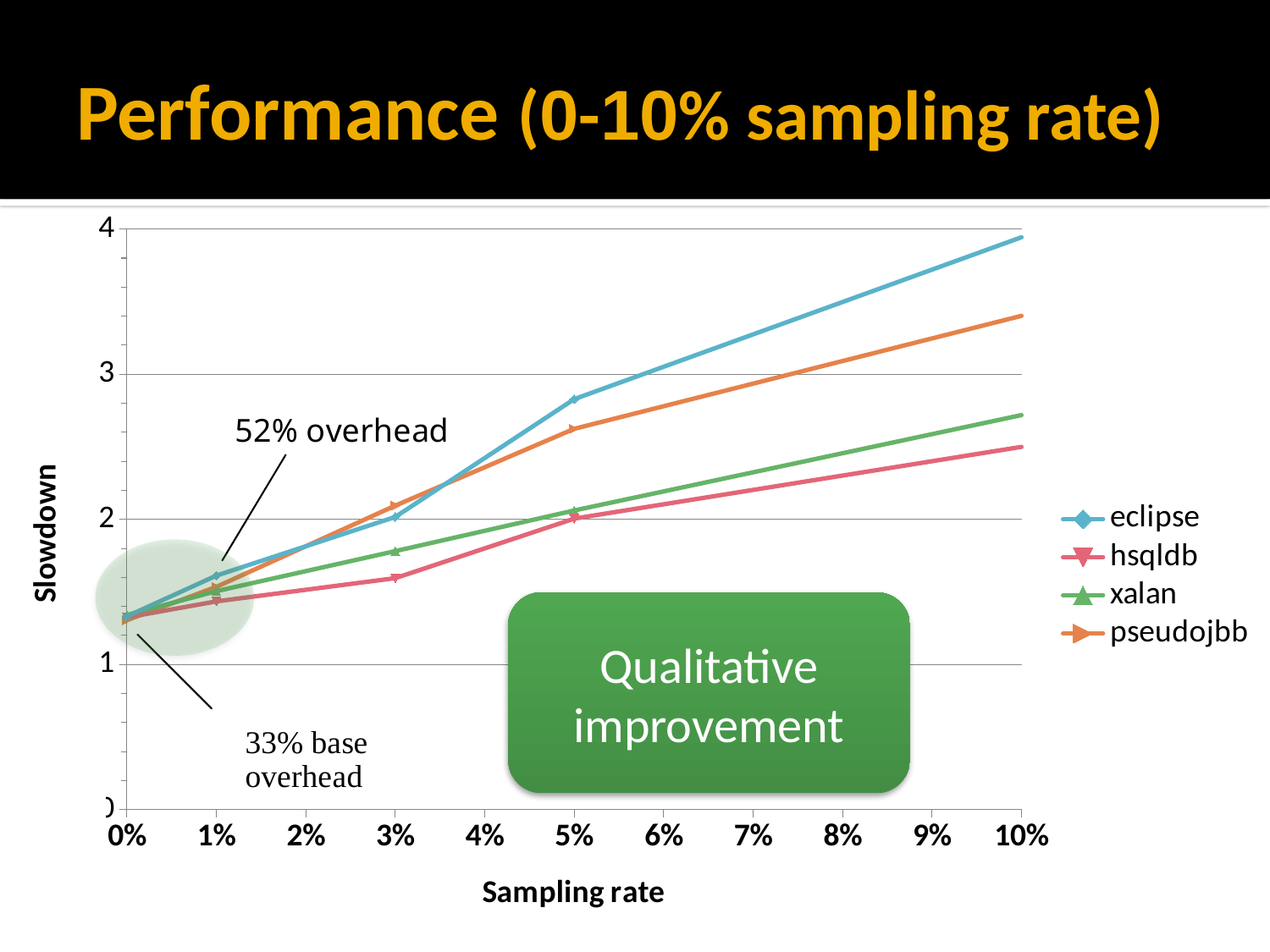
What is the label of the y axis? Slowdown Which series has the lowest slowdown at a 10% sampling rate? hsqldb Is the slowdown for eclipse at 10% sampling rate greater or less than 3? greater At a 10% sampling rate, which has the larger slowdown, pseudojbb or xalan? pseudojbb Is the slowdown for hsqldb at 10% sampling rate greater or less than 3? less Is the slowdown for hsqldb at 3% sampling rate greater or less than 2? less How many series does the legend list? 4 Which series are listed in the legend? eclipse, hsqldb, xalan, pseudojbb Which series has the highest slowdown at a 10% sampling rate? eclipse Do the slowdown values rise or fall as the sampling rate increases? rise What kind of chart is shown on the slide? line chart